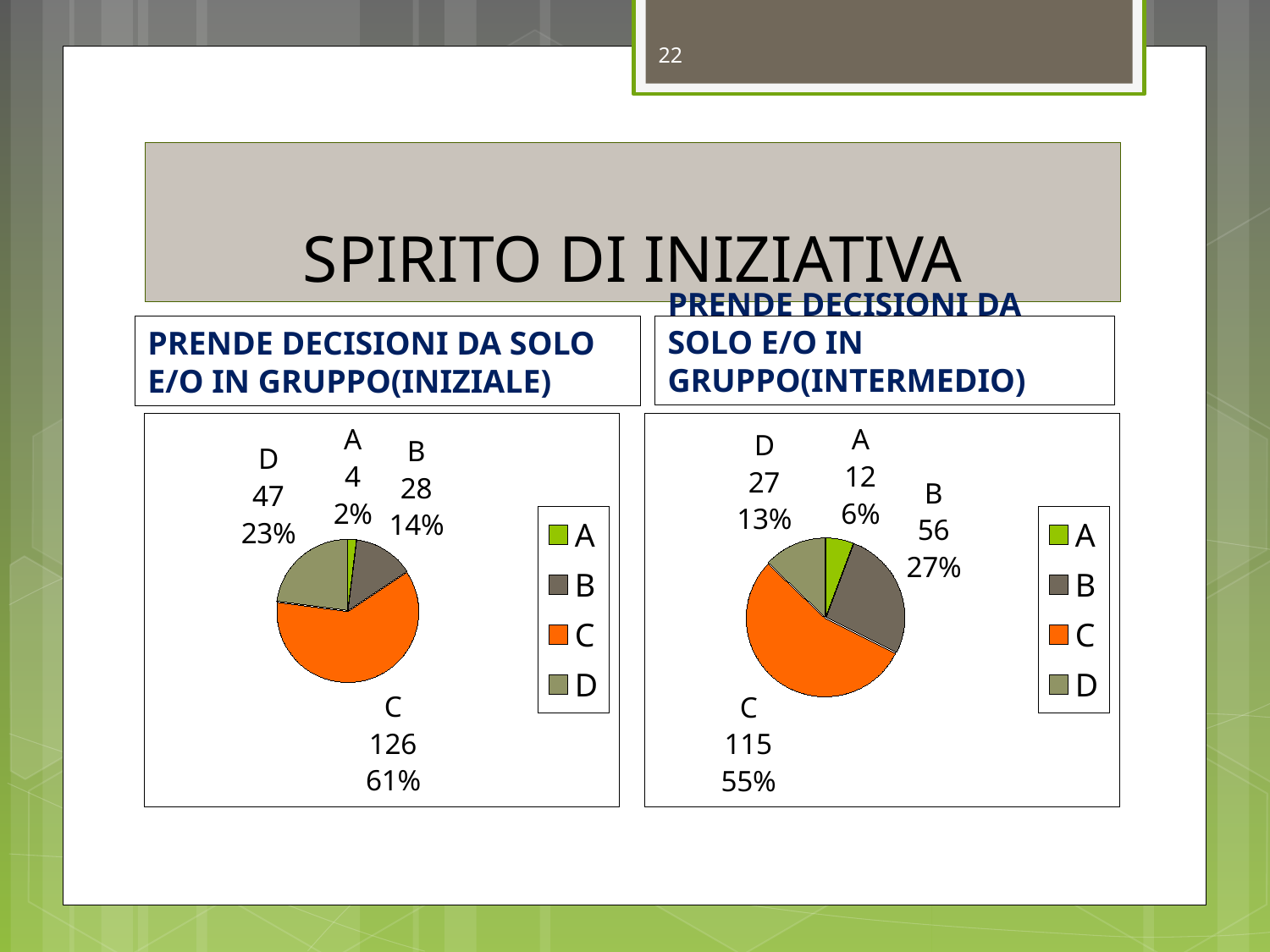
In the right chart (INTERMEDIO), what percentage share does slice A have? 6% In the right chart (INTERMEDIO), which category has the smallest slice? A In the left chart (INIZIALE), what is the value for category C? 126 In the right chart (INTERMEDIO), what colour is the slice for category C? Orange In the left chart (INIZIALE), what is the difference between the values for C and D? 79 Which is larger: the value for B in the left chart (INIZIALE) or the value for B in the right chart (INTERMEDIO)? Right chart (INTERMEDIO) In the right chart (INTERMEDIO), what is the difference between the values for B and D? 29 In the right chart (INTERMEDIO), what is the value for category B? 56 What type of chart is the right chart (INTERMEDIO)? Pie chart How many categories does the left chart (INIZIALE) show? 4 In the left chart (INIZIALE), which category has the largest slice? C In the left chart (INIZIALE), what percentage share does slice D have? 23%